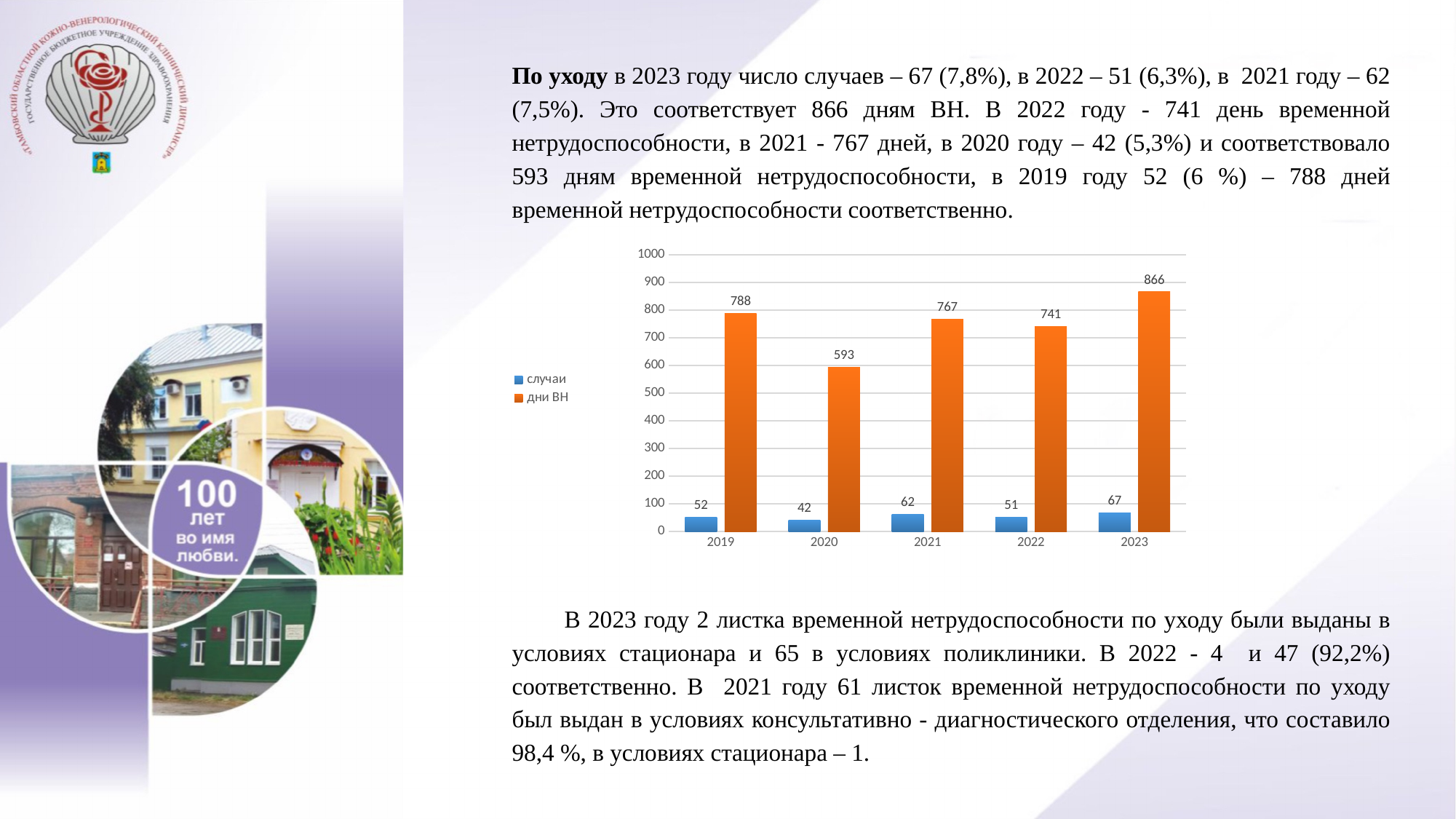
How many years are shown on the x axis of the chart? 5 What is the value of 'дни ВН' for 2023? 866 What is the difference between 'дни ВН' in 2023 and 2022? 125 Which year has the lowest value for 'случаи'? 2020 Which year has the highest value for 'дни ВН'? 2023 What colour are the bars for the 'дни ВН' series? orange What is the value of 'дни ВН' for 2021? 767 Is the value for 'дни ВН' in 2020 greater or less than 600? less Which is larger: 'случаи' in 2021 or 'случаи' in 2022? 2021 What kind of chart is shown on the slide? bar chart What is the value of 'случаи' for 2020? 42 How many series does the legend list? 2